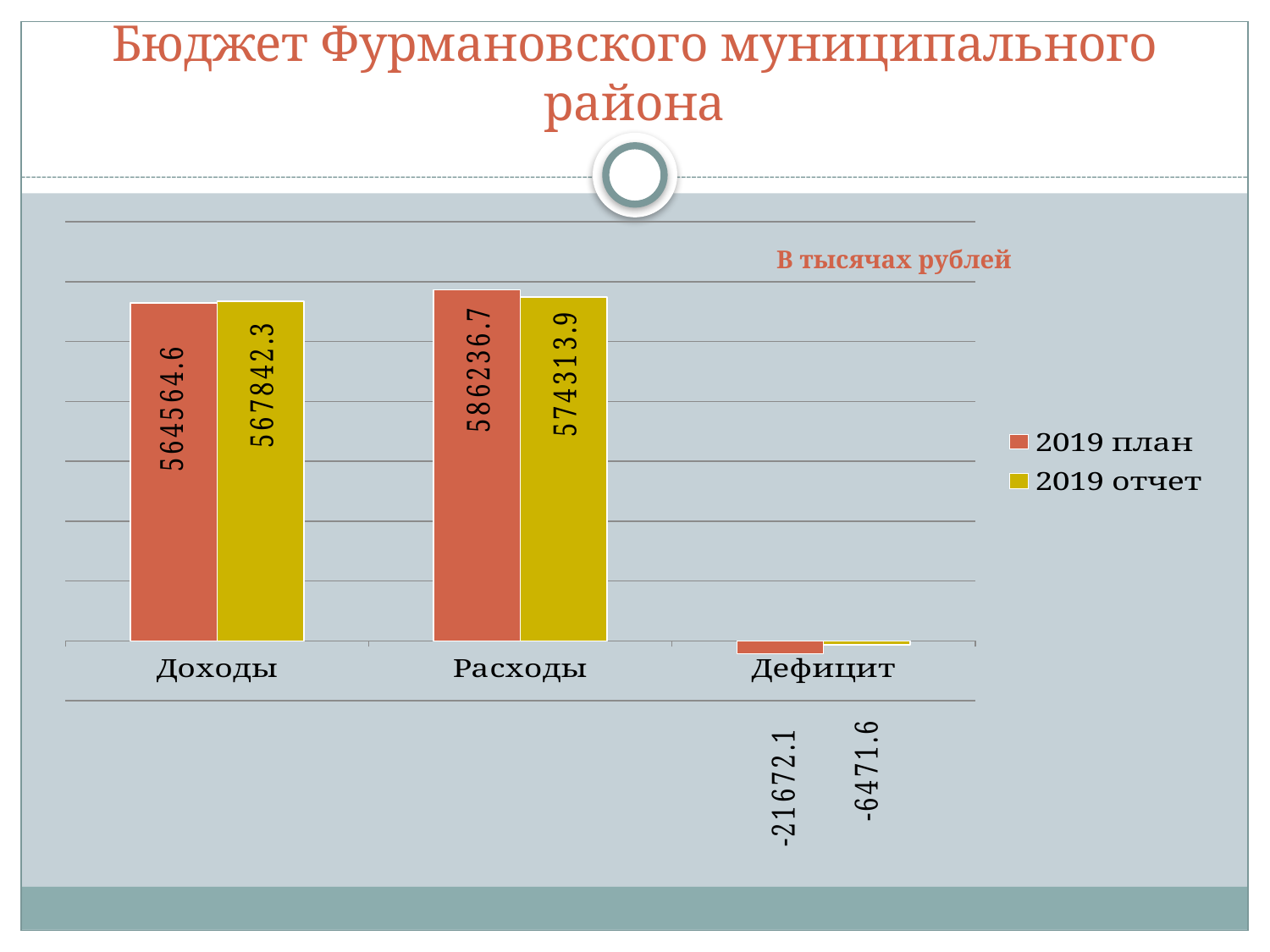
What is the difference between the 2019 отчет and 2019 план values for Доходы? 3277.7 What is the difference between the 2019 план and 2019 отчет values for Расходы? 11922.8 What is the value for Дефицит in the 2019 отчет series? -6471.6 What is the value for Дефицит in the 2019 план series? -21672.1 Which category has the highest value in the 2019 план series? Расходы What is the value for Доходы in the 2019 план series? 564564.6 How many categories are shown on the x axis? 3 Which category has the lowest value in the 2019 отчет series? Дефицит What kind of chart is shown on the slide? Bar chart How many series does the legend list? 2 What is the value for Расходы in the 2019 отчет series? 574313.9 For Доходы, which is larger: the 2019 план value or the 2019 отчет value? 2019 отчет